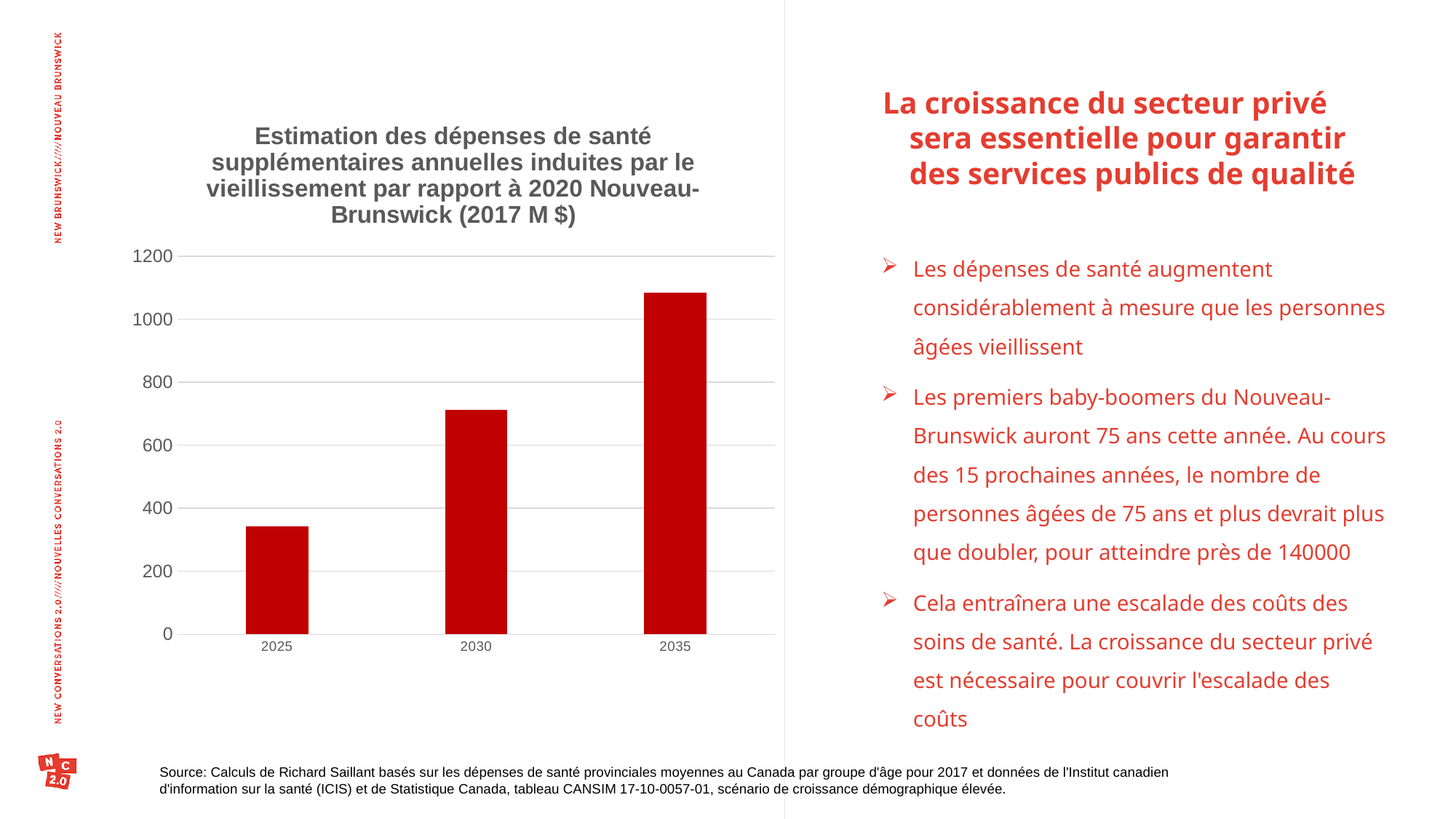
How many bars (categories) does the chart show? 3 What kind of chart is shown on the slide? bar chart Which year has the highest estimated additional health spending? 2035 Do the values rise or fall from 2025 to 2035? rise Is the value for 2035 greater or less than 1000? greater Is the value for 2030 greater or less than 600? greater Is the value for 2025 greater or less than 400? less Which year has the lowest estimated additional health spending? 2025 Which is larger, the value for 2030 or the value for 2035? 2035 What unit is given in the chart title for the values? 2017 M $